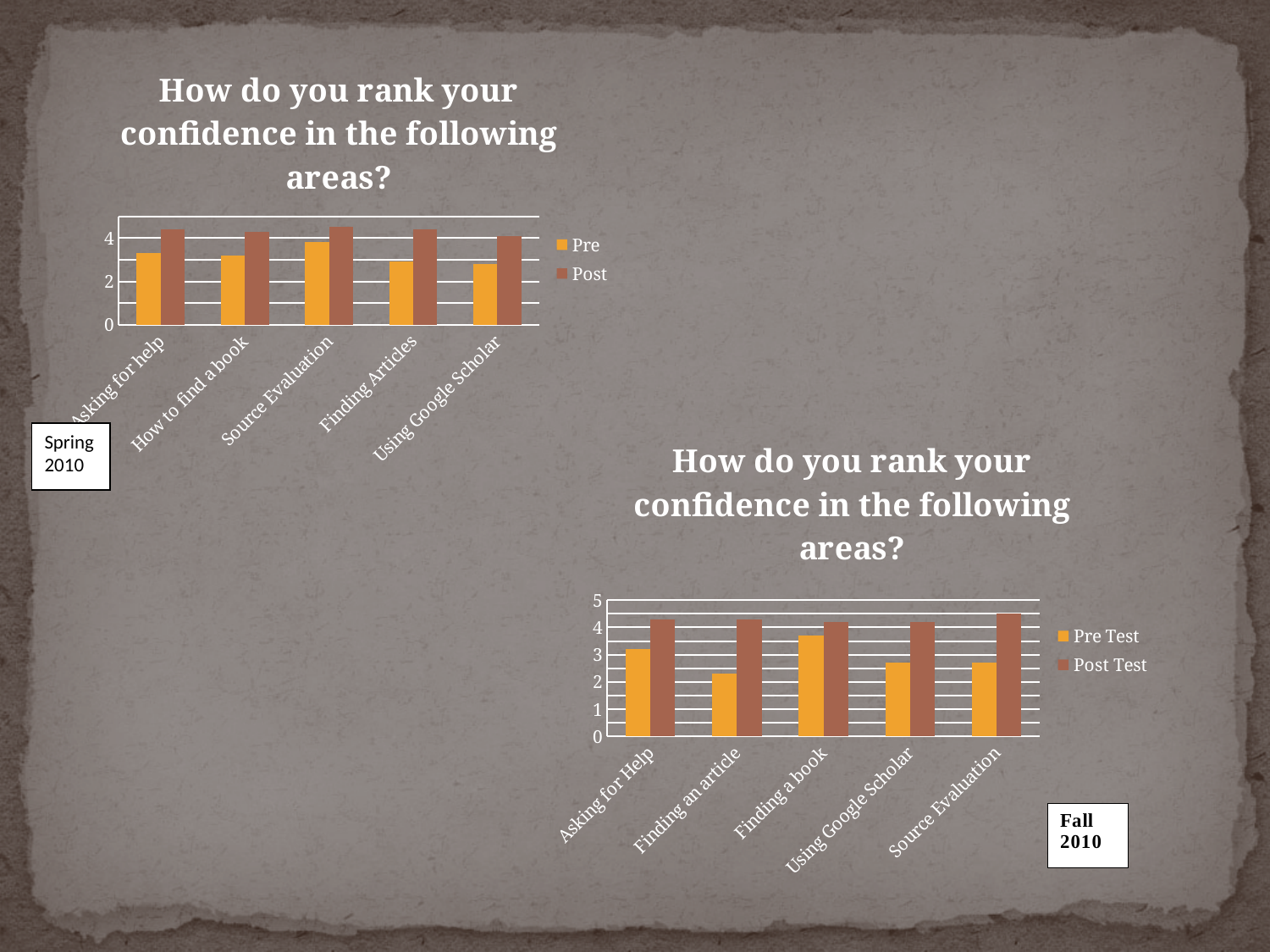
In the Fall 2010 chart, which category has the lowest Pre Test value? Finding an article In the Fall 2010 chart, which is larger: the Pre Test value for Asking for Help or the Pre Test value for Finding an article? Asking for Help In the Spring 2010 chart, is the Pre value for Using Google Scholar greater or less than 4? less What are the two legend entries of the Fall 2010 chart? Pre Test, Post Test How many categories are shown on the x axis of the Fall 2010 chart on the right? 5 In the Fall 2010 chart, which category has the highest Pre Test value? Finding a book How many series does the legend of the Spring 2010 chart list? 2 What type of chart is the Spring 2010 chart on the left? bar chart In the Fall 2010 chart, is the Pre Test value for Finding an article greater or less than 3? less In the Spring 2010 chart, is the Post value for Source Evaluation greater or less than 4? greater In the Spring 2010 chart, which category has the highest Pre value? Source Evaluation